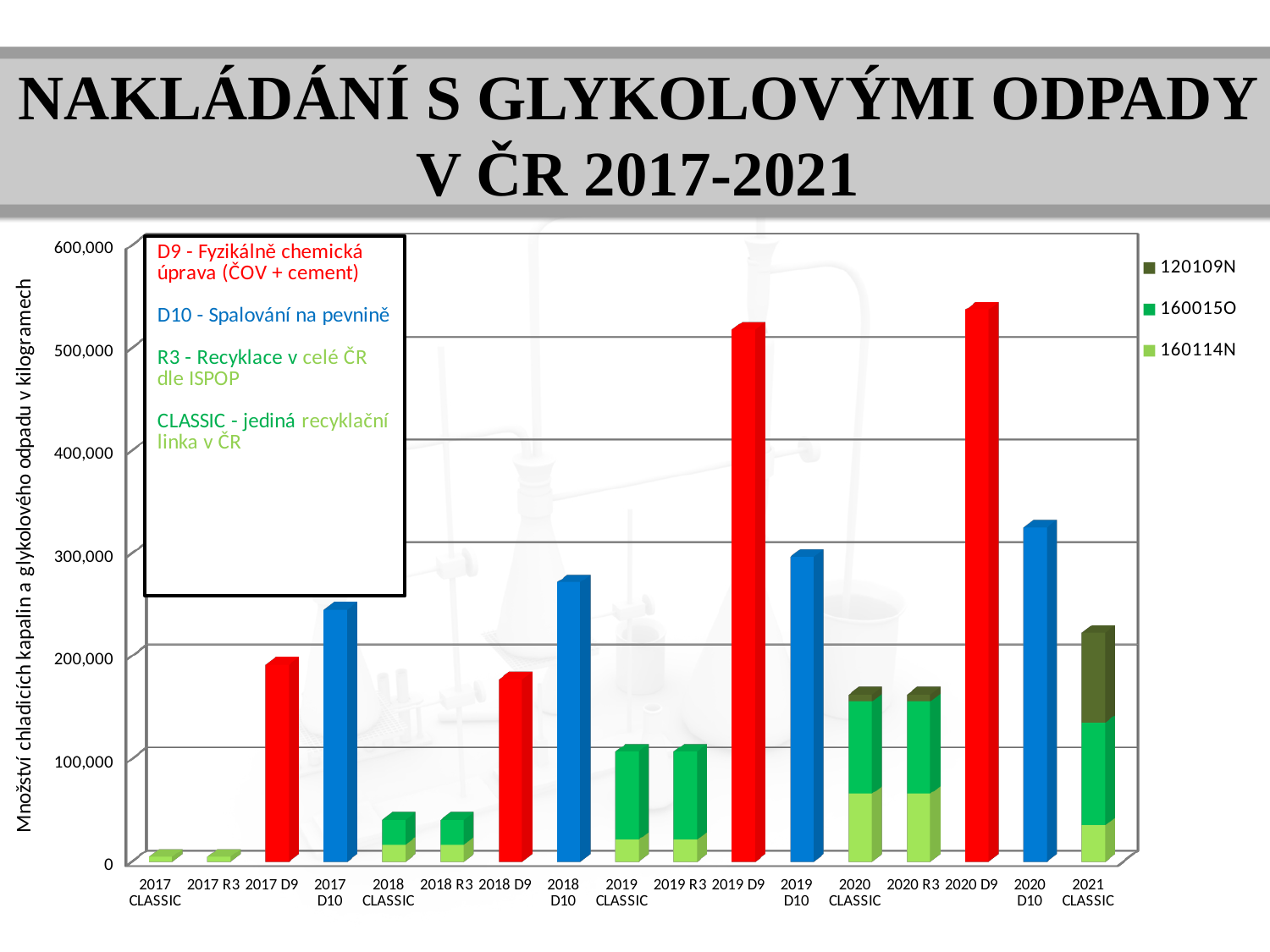
Which is larger, the value for 2020 D10 or the value for 2017 D10? 2020 D10 Is the value for 2020 D10 greater or less than 300,000? greater Is the total of the 2021 CLASSIC bar greater or less than 200,000? greater Is the value for 2019 D9 greater or less than 500,000? greater Which is larger, the value for 2019 D9 or the value for 2018 D9? 2019 D9 How many series does the chart legend list? 3 What kind of chart is shown on the slide? bar chart What are the three legend entries of the chart? 120109N, 160015O, 160114N How many categories are shown along the x axis of the chart? 17